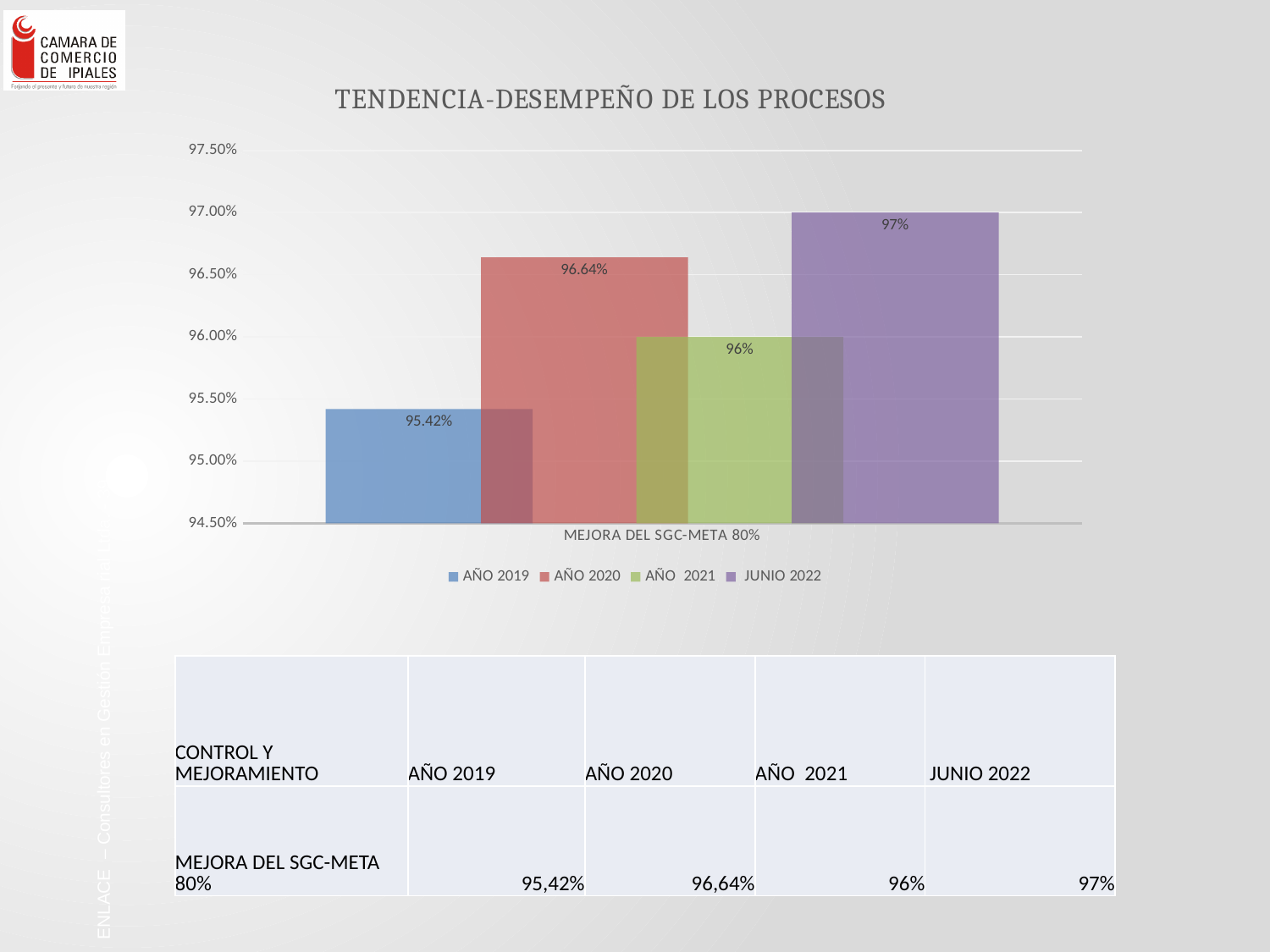
Which series has the highest value in the chart? JUNIO 2022 What is the value for AÑO 2019 in the chart? 95.42% What is the difference between the values for AÑO 2020 and AÑO 2019? 1.22% Is the value for AÑO 2019 greater or less than 95.50%? less How many series does the legend list? 4 Which series has the lowest value in the chart? AÑO 2019 Which is larger, the value for AÑO 2020 or the value for AÑO 2021? AÑO 2020 What is the value for AÑO 2020 in the chart? 96.64% What is the value for AÑO 2021 in the chart? 96% What is the title of the chart? TENDENCIA-DESEMPEÑO DE LOS PROCESOS What is the value for JUNIO 2022 in the chart? 97% What kind of chart is shown on the slide? bar chart